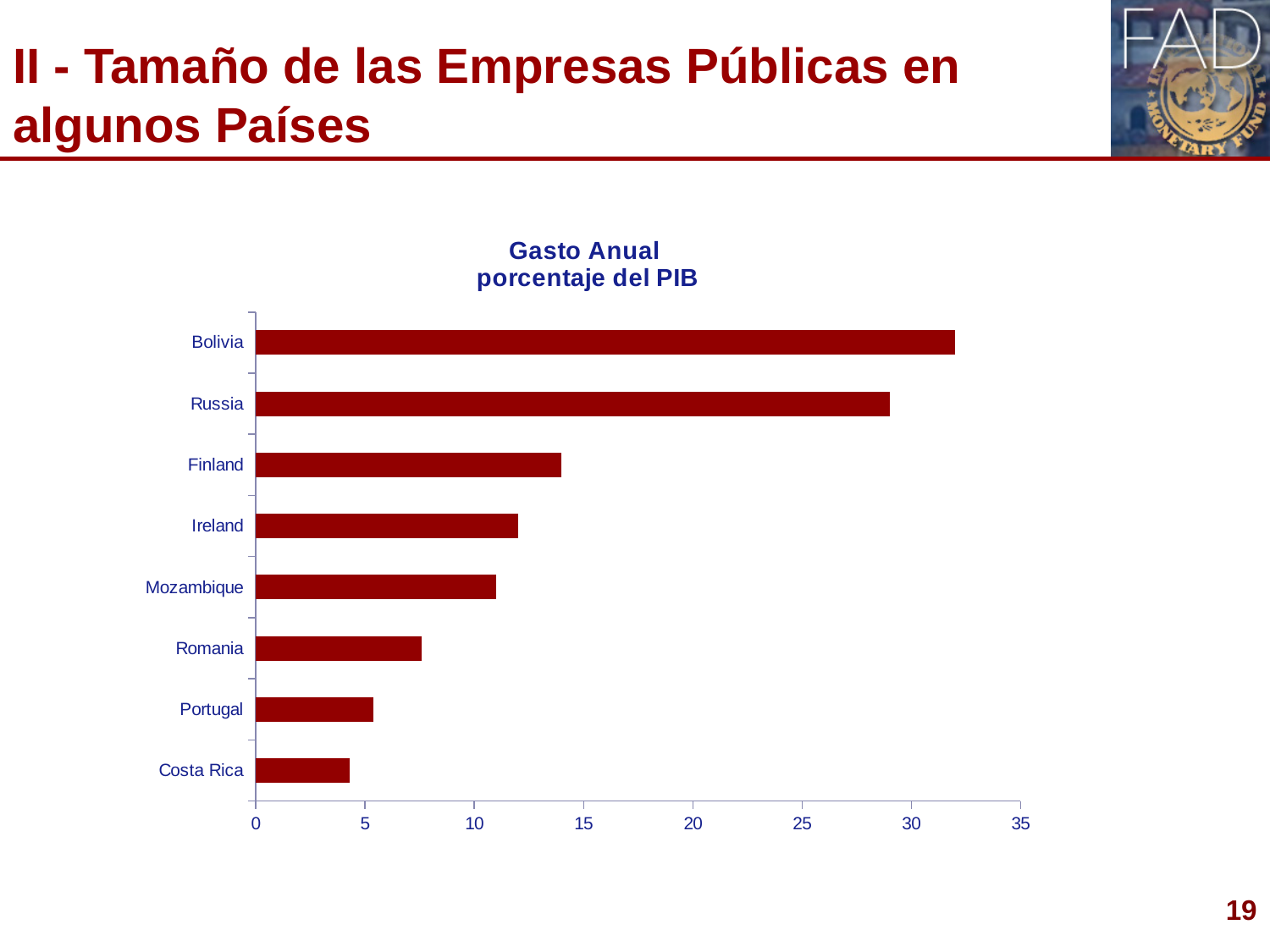
Which country has the lowest annual spending as a percentage of GDP? Costa Rica Which has a larger value, Finland or Ireland? Finland Is the value for Russia greater or less than 30? less Which country has the highest annual spending as a percentage of GDP? Bolivia Is the value for Finland greater or less than 15? less How many countries are shown in the chart? 8 What is the title of the chart? Gasto Anual porcentaje del PIB What kind of chart is shown on the slide? bar chart Is the value for Mozambique greater or less than 10? greater